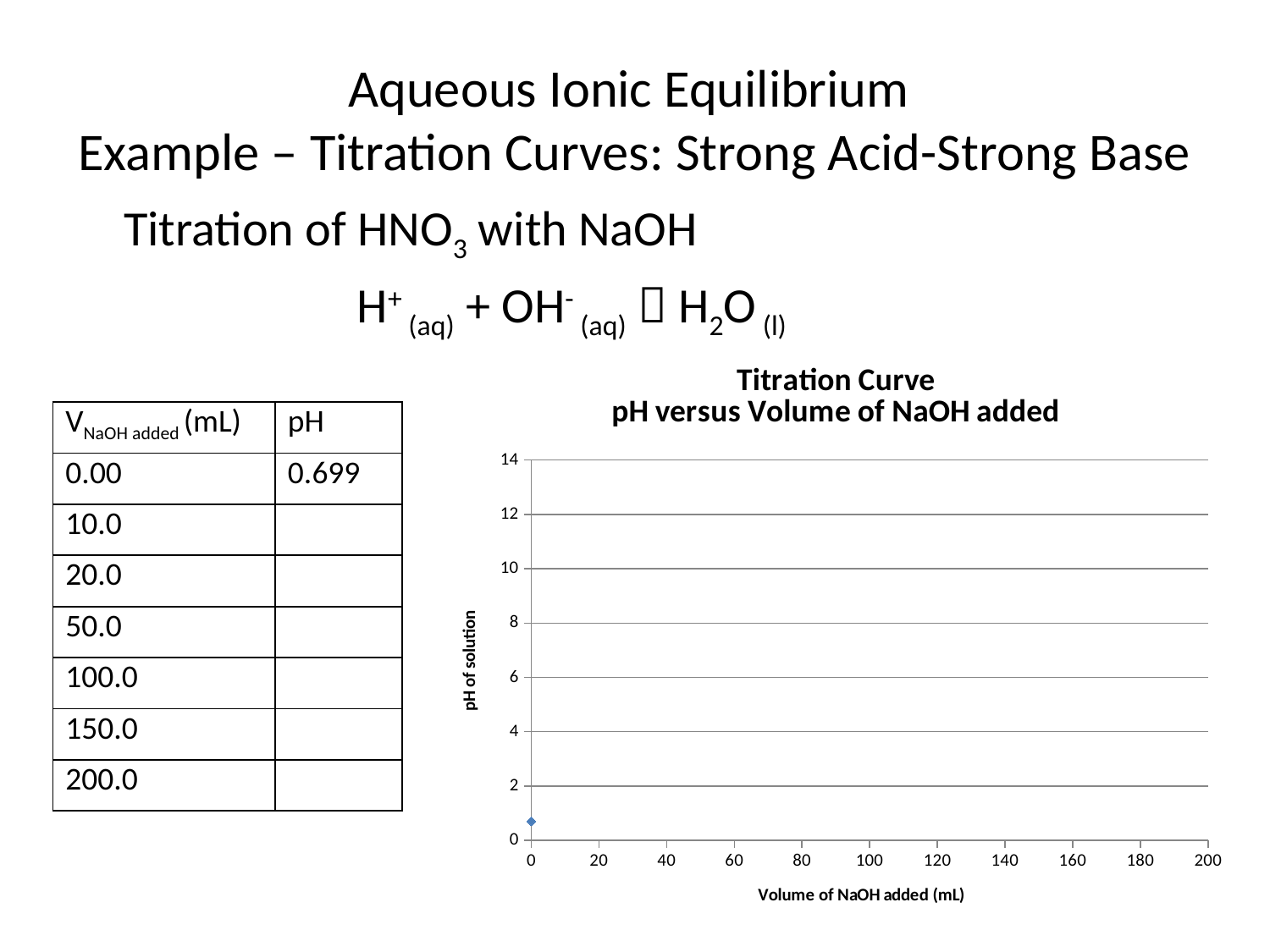
On the Titration Curve chart, is the pH value at 0 mL of NaOH added greater or less than 4? less What is the title of the chart on the slide? Titration Curve pH versus Volume of NaOH added What kind of chart is the Titration Curve chart? scatter chart What is the highest value shown on the y axis of the Titration Curve chart? 14 On the Titration Curve chart, is the pH value at 0 mL of NaOH added greater or less than 2? less What is the pH of the solution at 0.00 mL of NaOH added, as shown in the table next to the chart? 0.699 What is the highest value shown on the x axis of the Titration Curve chart? 200 How many data points are plotted on the Titration Curve chart? 1